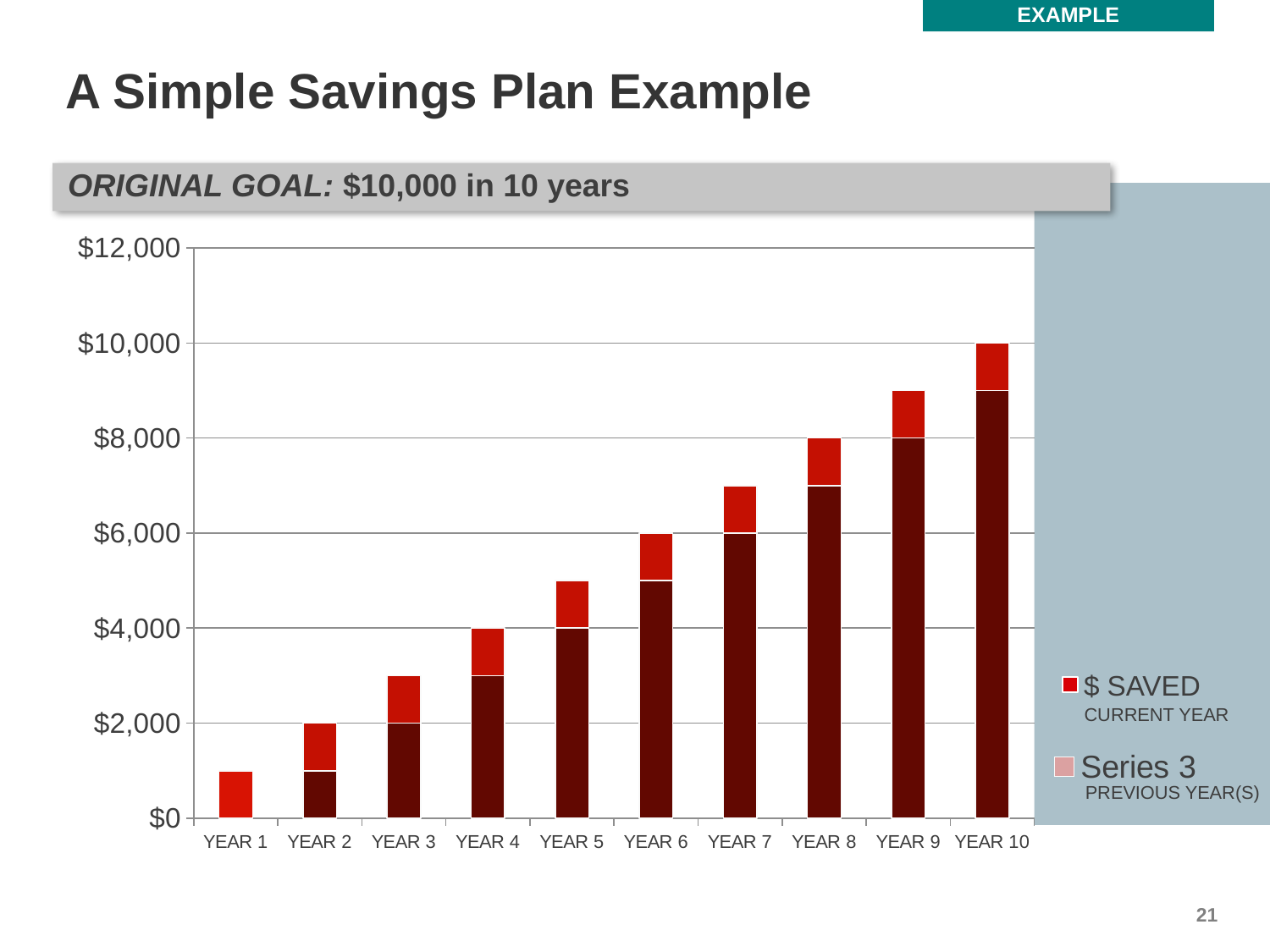
What kind of chart is shown on the slide? bar chart Is the total bar for YEAR 5 greater or less than $4,000? greater How many years (categories) are shown on the x axis of the chart? 10 Do the total bar heights rise or fall from YEAR 1 to YEAR 10? rise What is the total height of the stacked bar for YEAR 2? $2,000 What is the total height of the stacked bar for YEAR 10? $10,000 Which year has the highest total bar? YEAR 10 Which year has the lowest total bar? YEAR 1 Is the total bar for YEAR 1 greater or less than $2,000? less What is the original goal stated above the chart? $10,000 in 10 years How many series does the chart's legend list? 2 What is the total height of the stacked bar for YEAR 6? $6,000